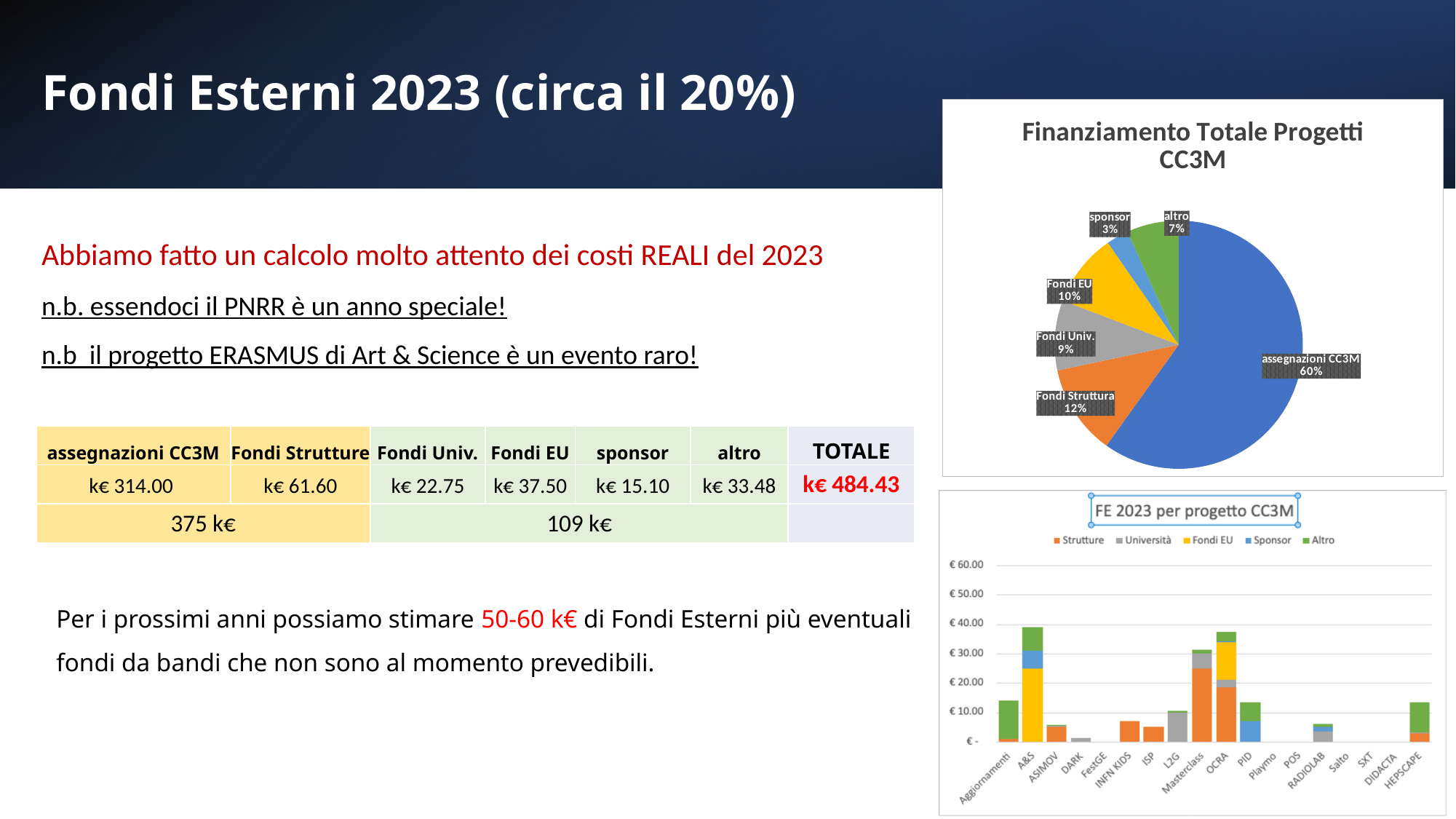
What kind of chart is 'FE 2023 per progetto CC3M'? Stacked bar chart In the pie chart 'Finanziamento Totale Progetti CC3M', what share does 'assegnazioni CC3M' have? 60% In the chart 'FE 2023 per progetto CC3M', is the total value for ASIMOV greater or less than € 10.00? less In the pie chart 'Finanziamento Totale Progetti CC3M', what is the difference in percentage points between 'Fondi Struttura' and 'Fondi Univ.'? 3 How many project categories are shown on the x axis of the chart 'FE 2023 per progetto CC3M'? 18 In the pie chart 'Finanziamento Totale Progetti CC3M', what percentage is shown for 'Fondi EU'? 10% In the pie chart 'Finanziamento Totale Progetti CC3M', how many slices are there? 6 In the pie chart 'Finanziamento Totale Progetti CC3M', which is larger, 'altro' or 'sponsor'? altro In the pie chart 'Finanziamento Totale Progetti CC3M', which slice is the smallest? sponsor How many series does the legend of the chart 'FE 2023 per progetto CC3M' list? 5 In the chart 'FE 2023 per progetto CC3M', is the total value for A&S greater or less than € 30.00? greater In the pie chart 'Finanziamento Totale Progetti CC3M', which slice is the largest? assegnazioni CC3M